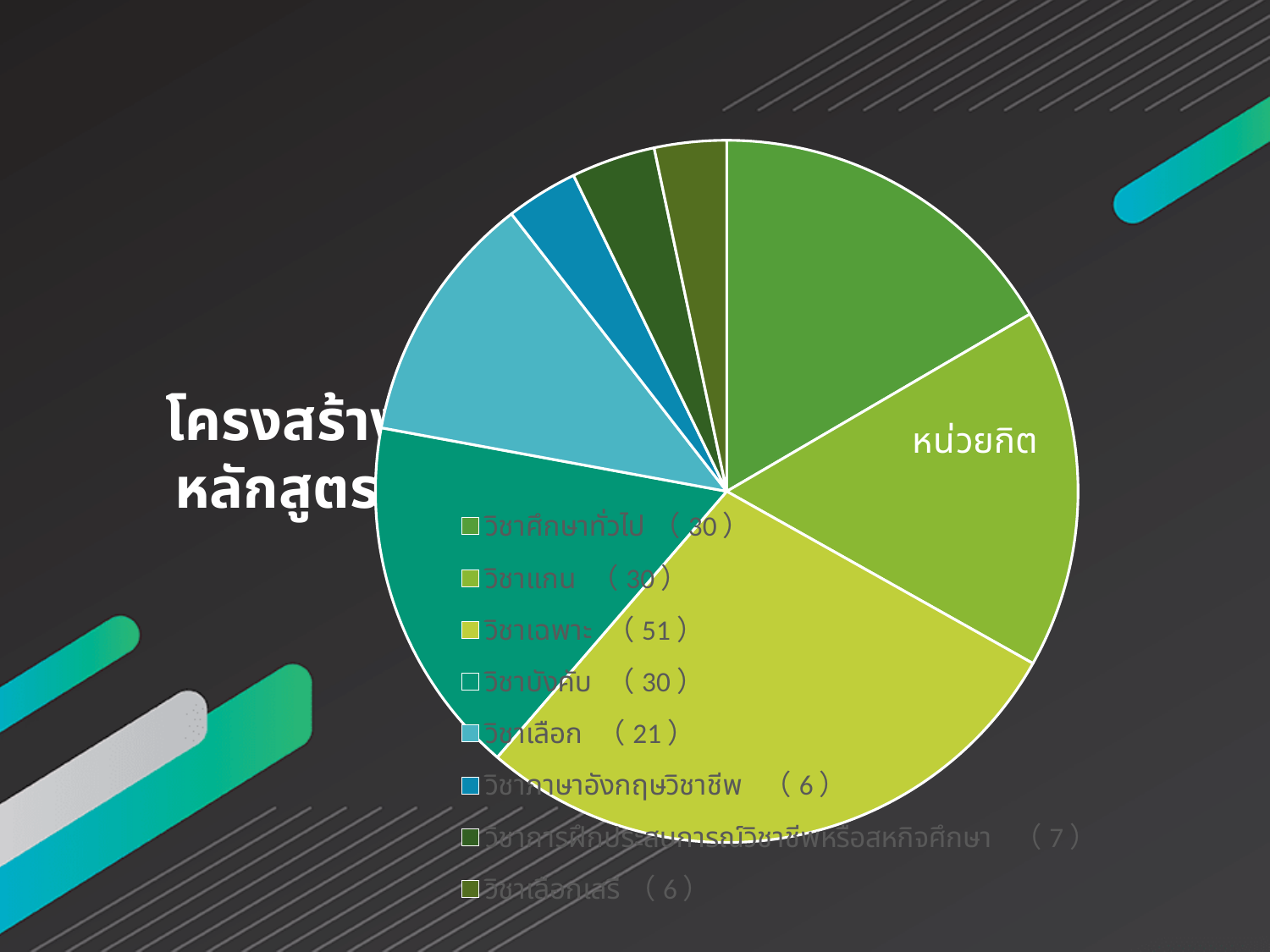
How many credits does the legend show for วิชาการฝึกประสบการณ์วิชาชีพหรือสหกิจศึกษา? 7 Which category has the largest slice of the pie? วิชาเฉพาะ What is the title of the pie chart? หน่วยกิต How many credits does the legend show for วิชาเลือก? 21 How many slices does the pie chart have? 8 How many credits does the legend show for วิชาศึกษาทั่วไป? 30 What is the total number of credits across all slices of the pie? 181 What is the difference in credits between วิชาเลือก and วิชาเลือกเสรี? 15 What is the difference in credits between วิชาเฉพาะ and วิชาเลือก? 30 How many credits does the legend show for วิชาเฉพาะ? 51 Which has more credits, วิชาเลือก or วิชาภาษาอังกฤษวิชาชีพ? วิชาเลือก What kind of chart is shown on the slide? pie chart